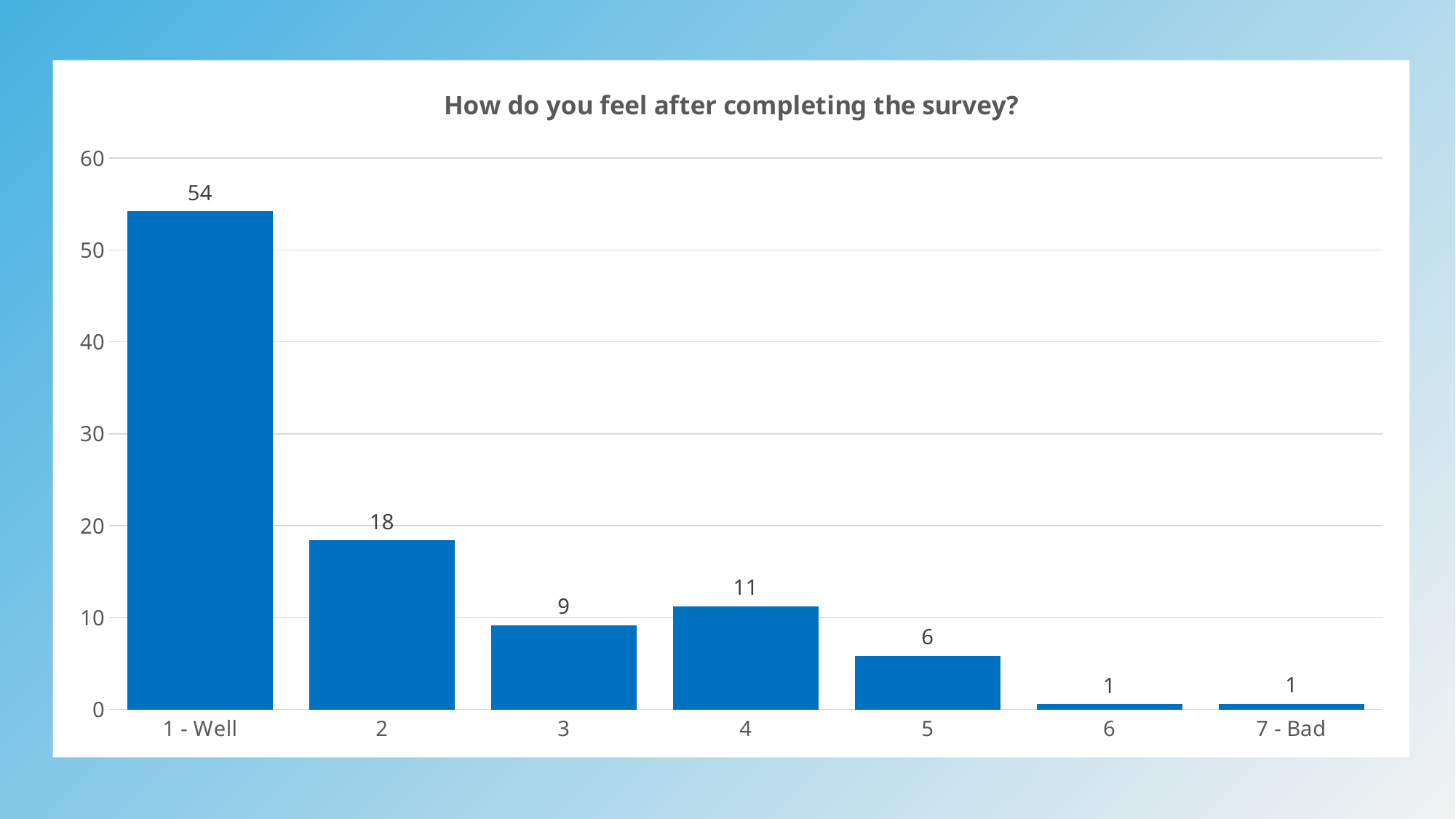
What is the value for the category "1 - Well"? 54 Do the values generally rise or fall from left to right along the x axis? fall What kind of chart is shown on the slide? bar chart What is the difference between the values for "1 - Well" and category 2? 36 Is the value for category 2 greater or less than 20? less Which is larger, the value for category 3 or the value for category 5? 3 How many categories are shown on the x axis? 7 Which category has the highest value? 1 - Well What is the value for the category "7 - Bad"? 1 What is the value for category 4? 11 What is the difference between the values for category 4 and category 3? 2 What is the title of the chart? How do you feel after completing the survey?